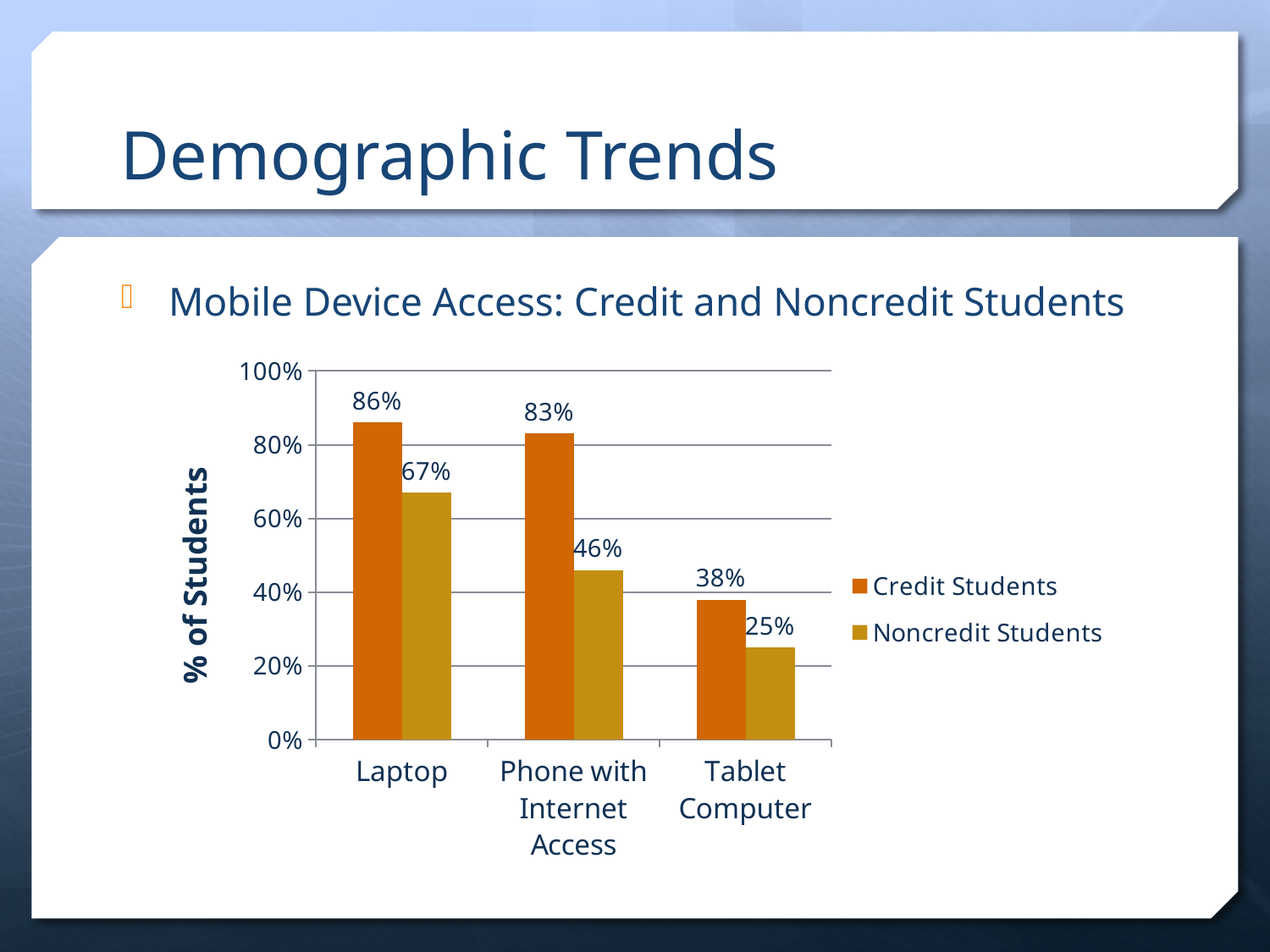
Which is larger: the Credit Students value for Tablet Computer or the Noncredit Students value for Phone with Internet Access? Noncredit Students value for Phone with Internet Access What percentage of Credit Students have a laptop? 86% Which device category has the lowest value for Noncredit Students? Tablet Computer How many device categories are shown on the x axis? 3 What kind of chart is shown on the slide? Bar chart What is the value for Noncredit Students for Tablet Computer? 25% What is the label of the y axis? % of Students Which device category has the highest value for Credit Students? Laptop What percentage of Noncredit Students have a phone with internet access? 46% How many series does the legend list? 2 What is the difference between Credit Students and Noncredit Students for Laptop? 19% What is the difference between Credit Students and Noncredit Students for Phone with Internet Access? 37%